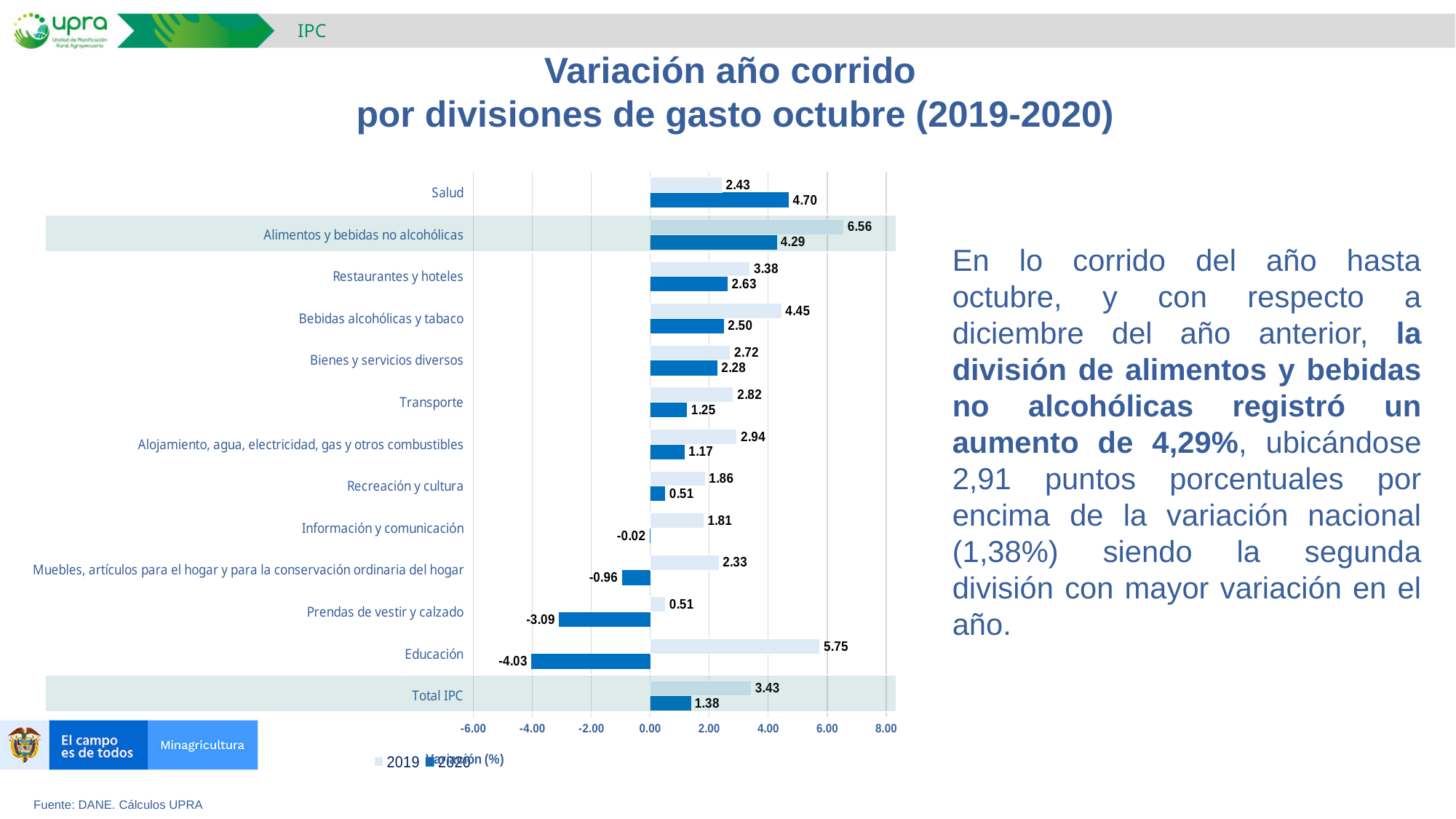
Which category has the highest 2019 value? Alimentos y bebidas no alcohólicas What is the 2019 value for Alimentos y bebidas no alcohólicas? 6.56 Which category has the lowest 2020 value? Educación Which is larger for Transporte, the 2019 value or the 2020 value? 2019 What is the 2020 value for Total IPC? 1.38 What is the difference between the 2019 and 2020 values for Total IPC? 2.05 How many series does the chart legend list? 2 What type of chart is shown on the slide? Bar chart What is the 2020 value for Salud? 4.70 What is the 2020 value for Educación? -4.03 How many categories are shown on the chart, including Total IPC? 13 Which category has the highest 2020 value? Salud